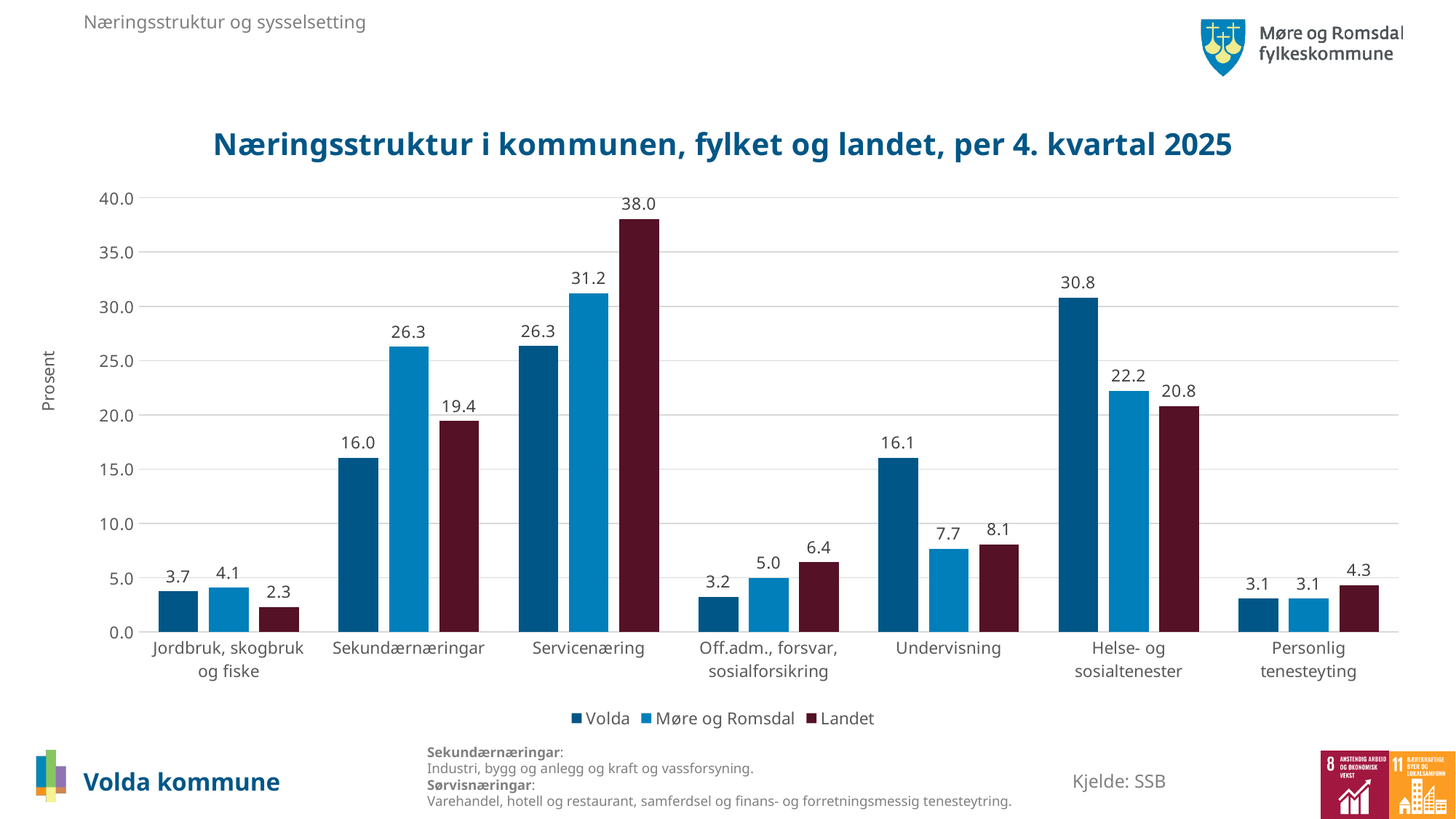
What is the value for Landet in the Servicenæring category? 38.0 What is the difference between the Landet and Volda values in the Servicenæring category? 11.7 Is the value for Møre og Romsdal in the Helse- og sosialtenester category greater or less than 20.0? greater What kind of chart is shown on the slide? Bar chart How many categories are shown on the x axis? 7 Which category has the lowest value for Landet? Jordbruk, skogbruk og fiske In the Undervisning category, which is larger: the value for Volda or the value for Landet? Volda What is the title of the chart? Næringsstruktur i kommunen, fylket og landet, per 4. kvartal 2025 How many series does the legend list? 3 What is the value for Volda in the Helse- og sosialtenester category? 30.8 What is the value for Møre og Romsdal in the Sekundærnæringar category? 26.3 Which category has the highest value for Volda? Helse- og sosialtenester